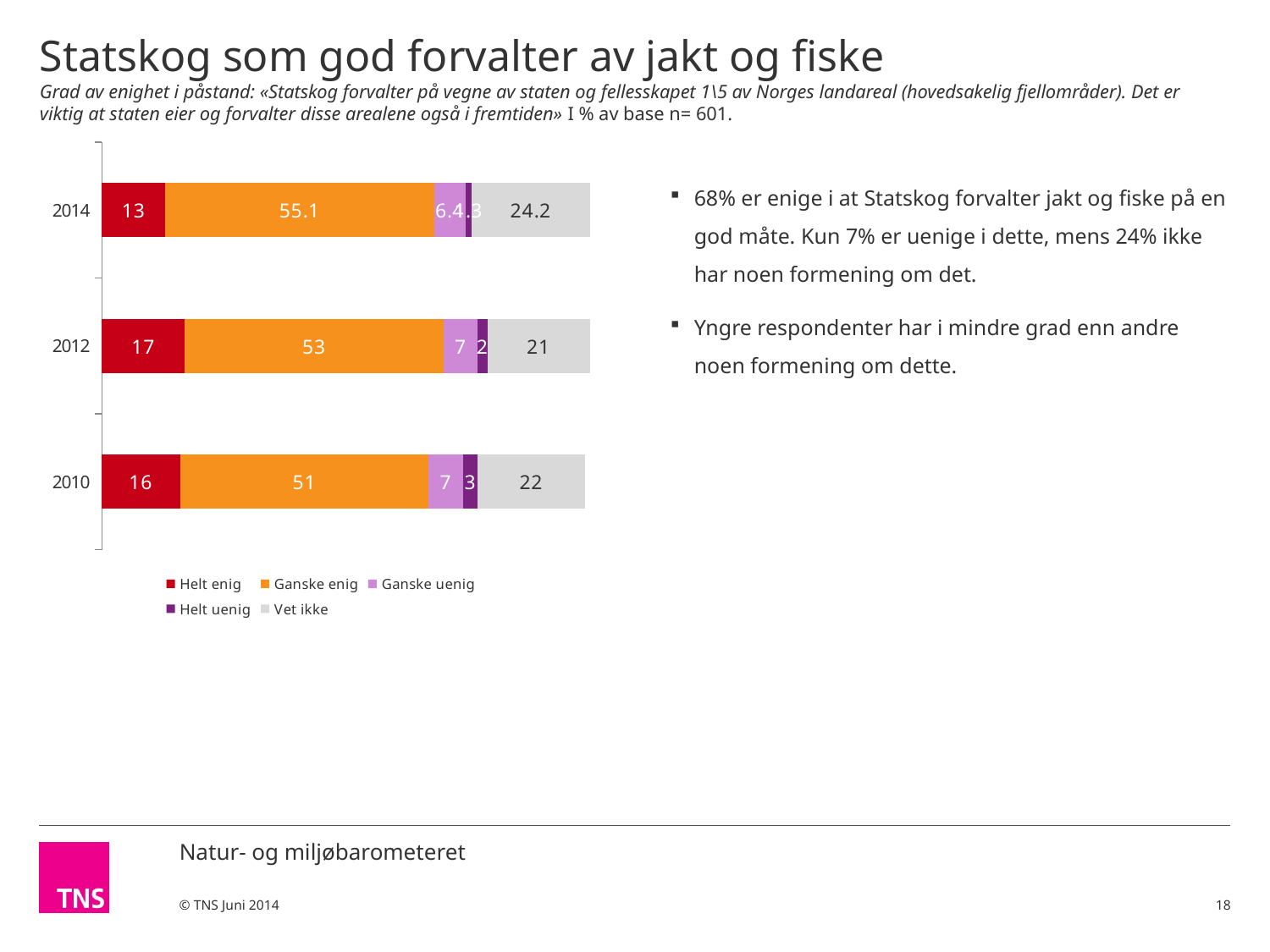
What is the total of the stacked bar for 2012? 100 In which year is the Helt enig value highest? 2012 What is the value for Ganske enig in 2014? 55.1 Which year has the larger Vet ikke value, 2014 or 2012? 2014 What kind of chart is shown on the slide? Stacked bar chart How many series does the legend list? 5 What is the value for Vet ikke in 2010? 22 Which colour represents Ganske enig in the legend? Orange In which year is the Vet ikke value lowest? 2012 What is the value for Helt enig in 2012? 17 How many years are shown on the chart? 3 What is the difference between the Ganske enig values for 2014 and 2010? 4.1